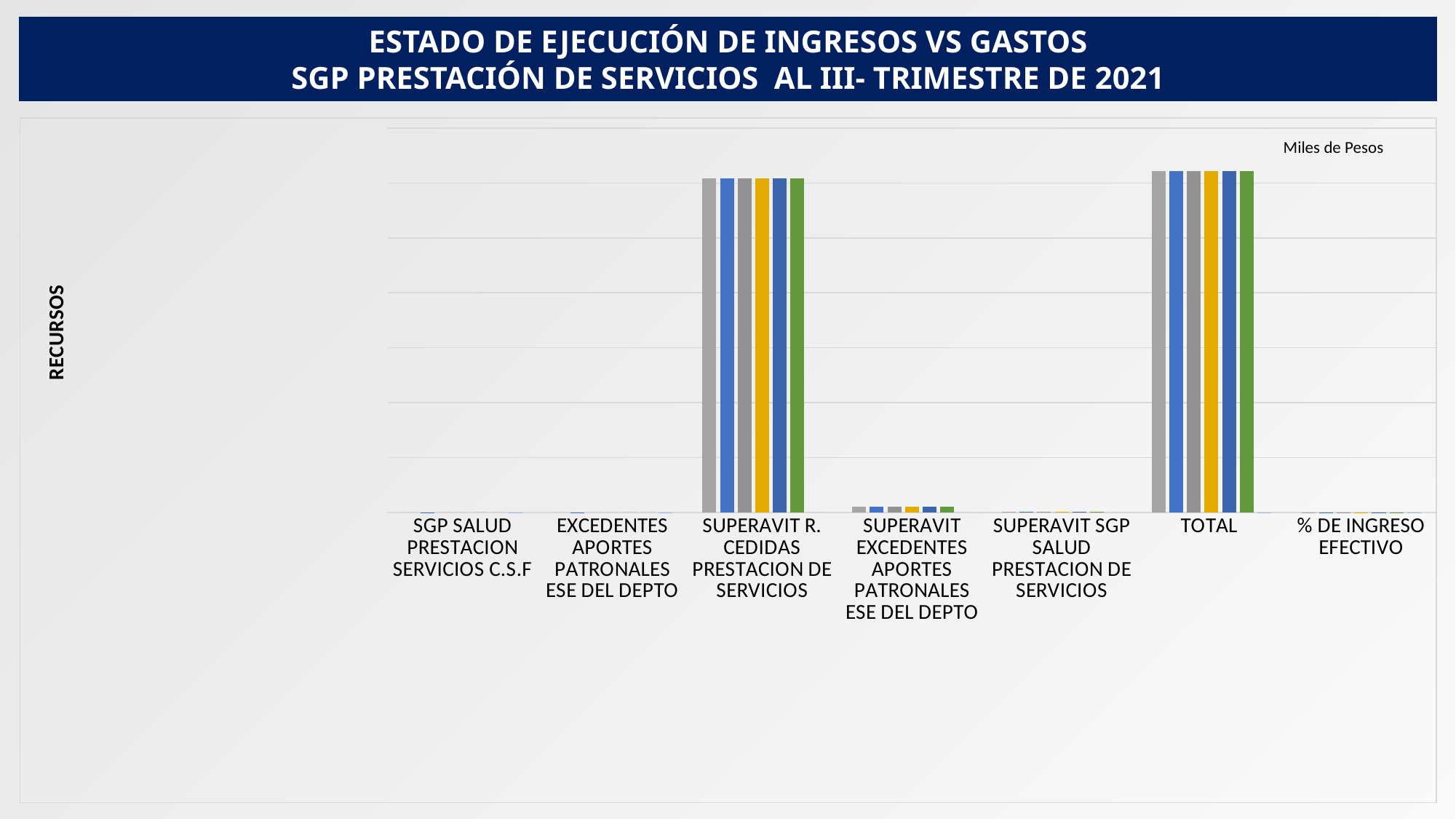
How many bars are plotted for the TOTAL category? 6 Which category has the tallest bars in the chart? TOTAL Which category has taller bars, SUPERAVIT R. CEDIDAS PRESTACION DE SERVICIOS or SUPERAVIT EXCEDENTES APORTES PATRONALES ESE DEL DEPTO? SUPERAVIT R. CEDIDAS PRESTACION DE SERVICIOS How many categories are shown along the x axis of the chart? 7 Which category has taller bars, SUPERAVIT EXCEDENTES APORTES PATRONALES ESE DEL DEPTO or SUPERAVIT SGP SALUD PRESTACION DE SERVICIOS? SUPERAVIT EXCEDENTES APORTES PATRONALES ESE DEL DEPTO What kind of chart is shown on the slide? bar chart What is the label on the vertical axis of the chart? RECURSOS What unit note is printed in the top right corner of the chart area? Miles de Pesos Which category has taller bars, TOTAL or EXCEDENTES APORTES PATRONALES ESE DEL DEPTO? TOTAL